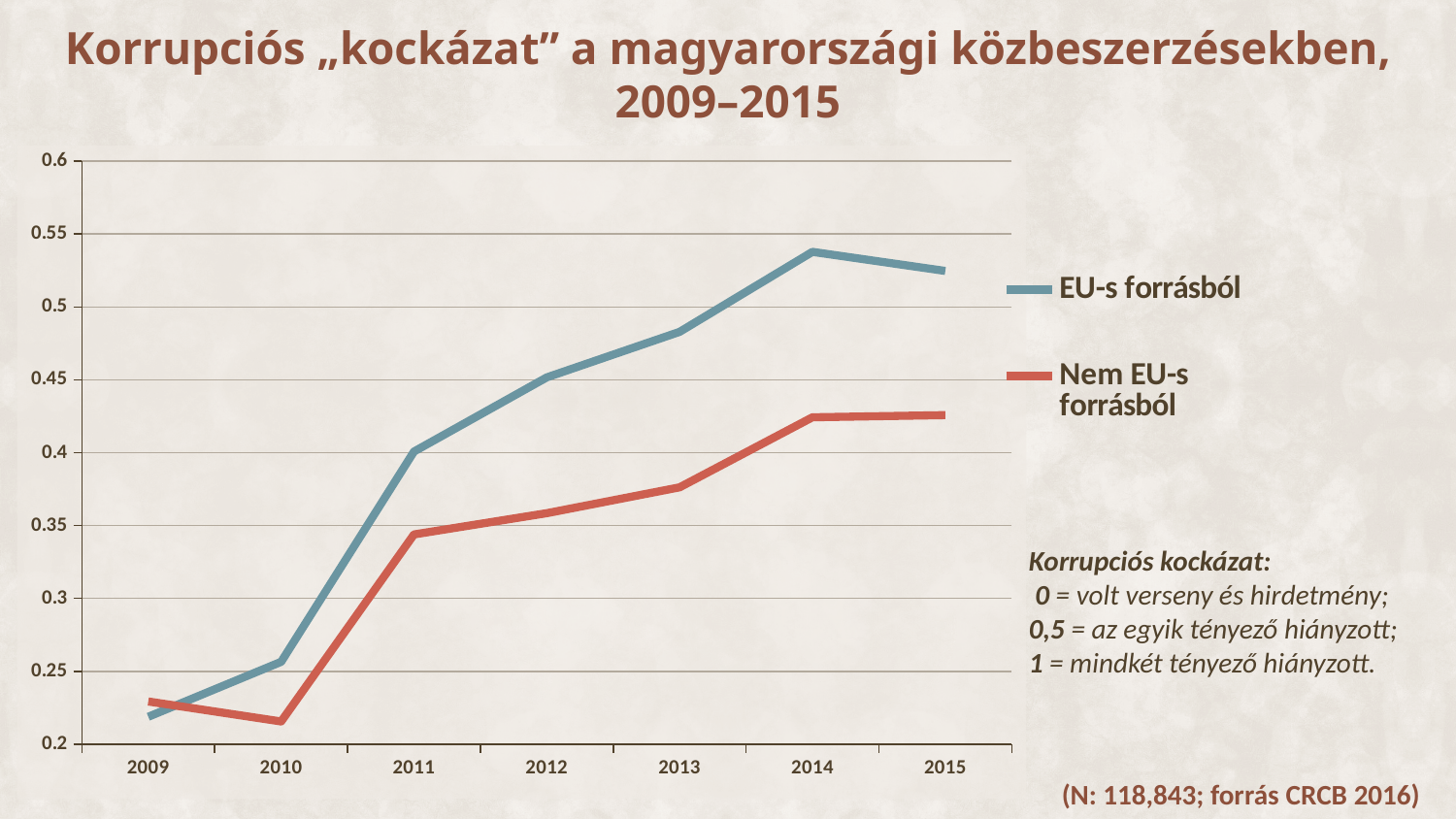
Is the value for 'EU-s forrásból' in 2009 greater or less than 0.25? less Is the value for 'Nem EU-s forrásból' in 2013 greater or less than 0.35? greater In 2013, which series has the higher value, 'EU-s forrásból' or 'Nem EU-s forrásból'? EU-s forrásból How many series does the legend list? 2 In which year does the 'EU-s forrásból' series reach its highest value? 2014 Which series is drawn in red? Nem EU-s forrásból In which year does the 'EU-s forrásból' series have its lowest value? 2009 How many years are plotted along the x axis? 7 Is the value for 'Nem EU-s forrásból' in 2015 greater or less than 0.45? less Does the 'EU-s forrásból' series rise or fall between 2010 and 2014? rise What kind of chart is shown on the slide? line chart